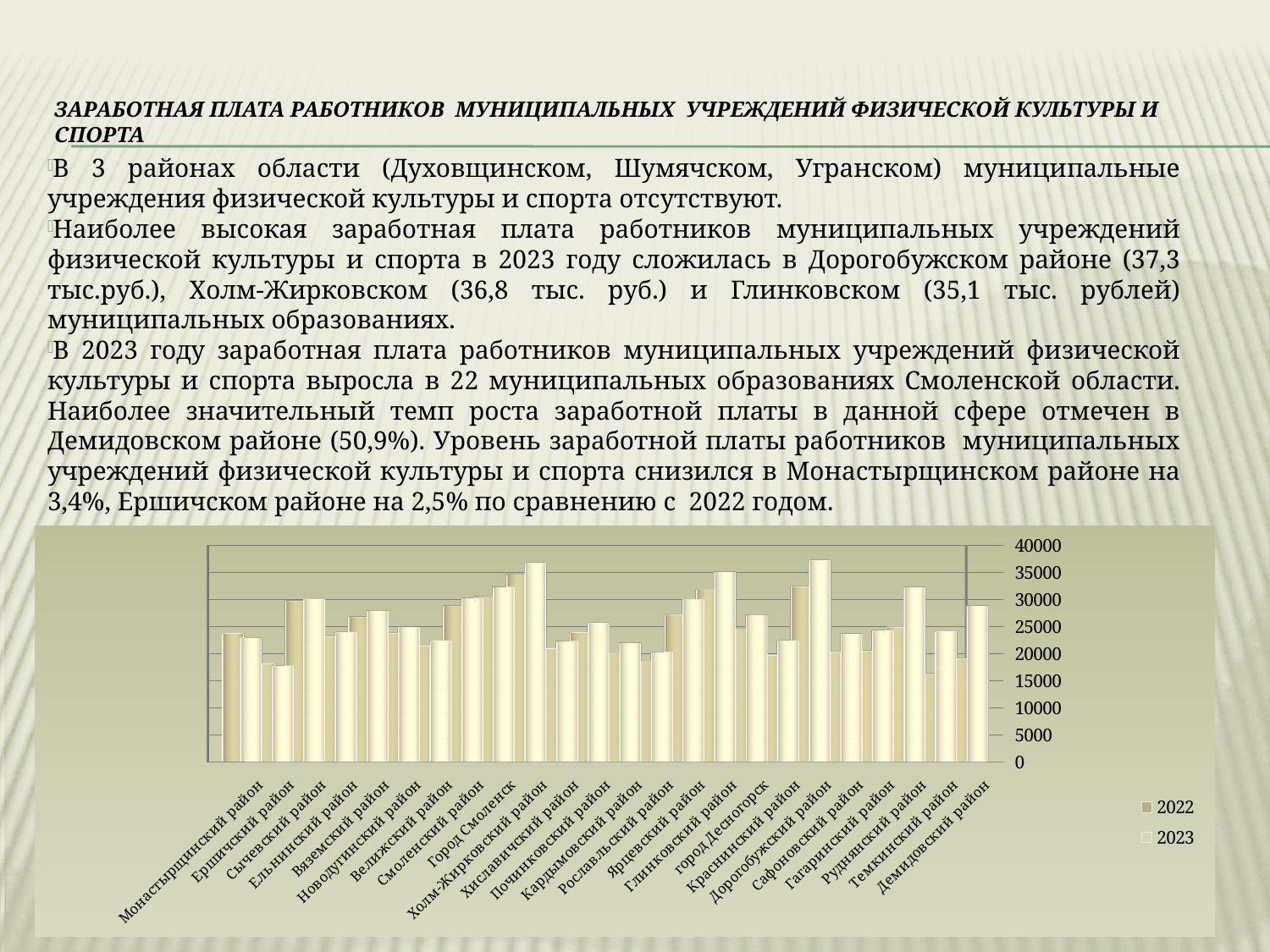
Is the 2023 value for Холм-Жирковский район greater or less than 35000? greater Is the 2023 value for Демидовский район greater or less than 25000? greater For Демидовский район, which year has the larger value, 2022 or 2023? 2023 How many series does the chart legend list? 2 Is the 2022 value for Темкинский район greater or less than 20000? less Which years are listed in the chart legend? 2022 and 2023 For Темкинский район, which year has the larger value, 2022 or 2023? 2023 What kind of chart is shown on the slide? bar chart Which district has the lowest 2023 value in the chart? Ершичский район How many municipal districts (categories) are shown on the x axis of the chart? 24